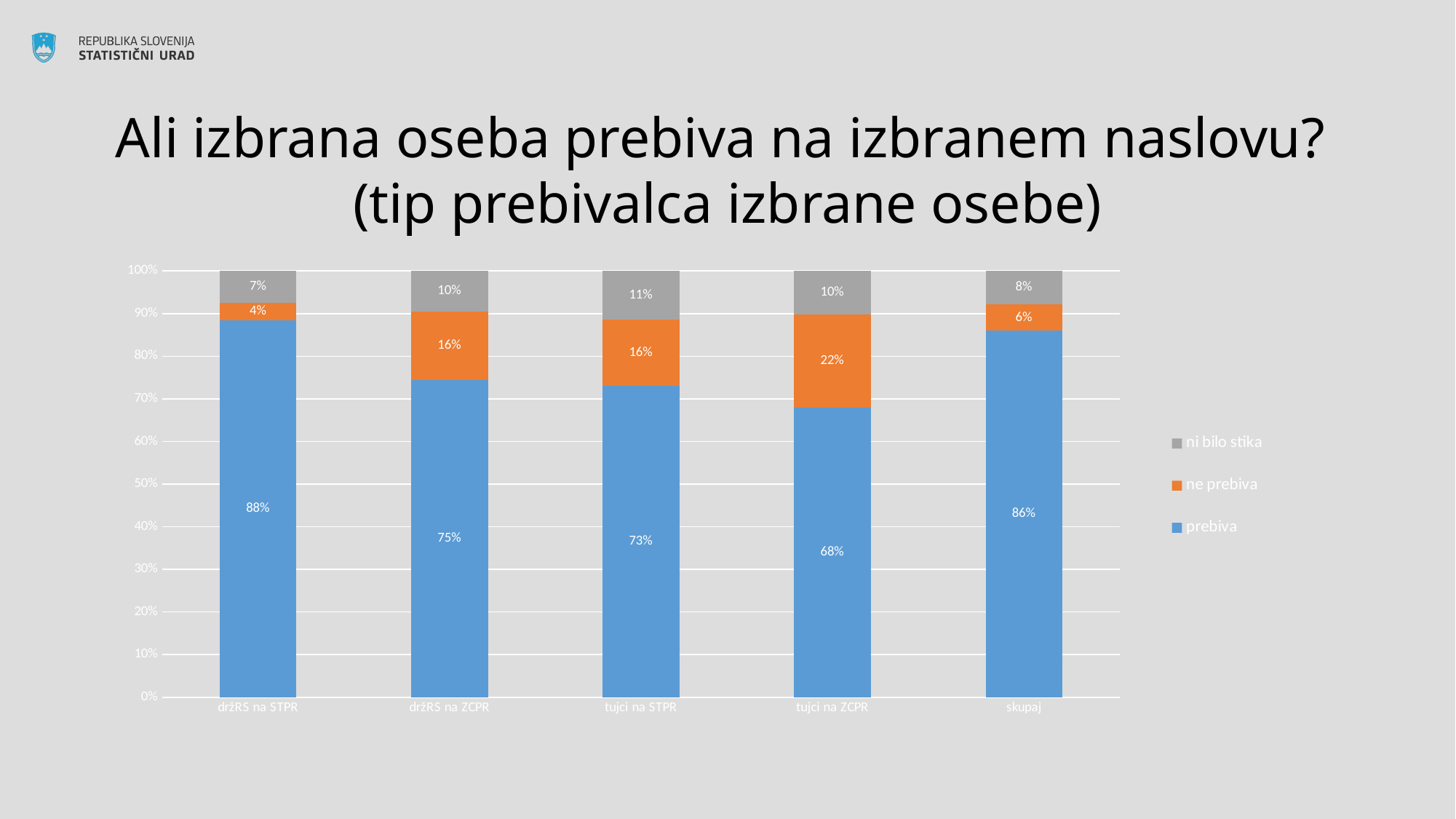
What kind of chart is shown on the slide? Stacked bar chart How many series does the legend list? 3 How many categories are shown on the x axis? 5 What is the 'ne prebiva' value for tujci na ZCPR? 22% What is the difference between the 'prebiva' values for držRS na STPR and tujci na ZCPR? 20 percentage points Which is larger, the 'ne prebiva' value for držRS na ZCPR or for skupaj? držRS na ZCPR Which category has the lowest 'prebiva' value? tujci na ZCPR Which category has the highest 'prebiva' value? držRS na STPR What is the 'ni bilo stika' value for tujci na STPR? 11% What is the 'prebiva' value for skupaj? 86% Which colour represents the 'ne prebiva' series? Orange What is the 'prebiva' value for držRS na STPR? 88%